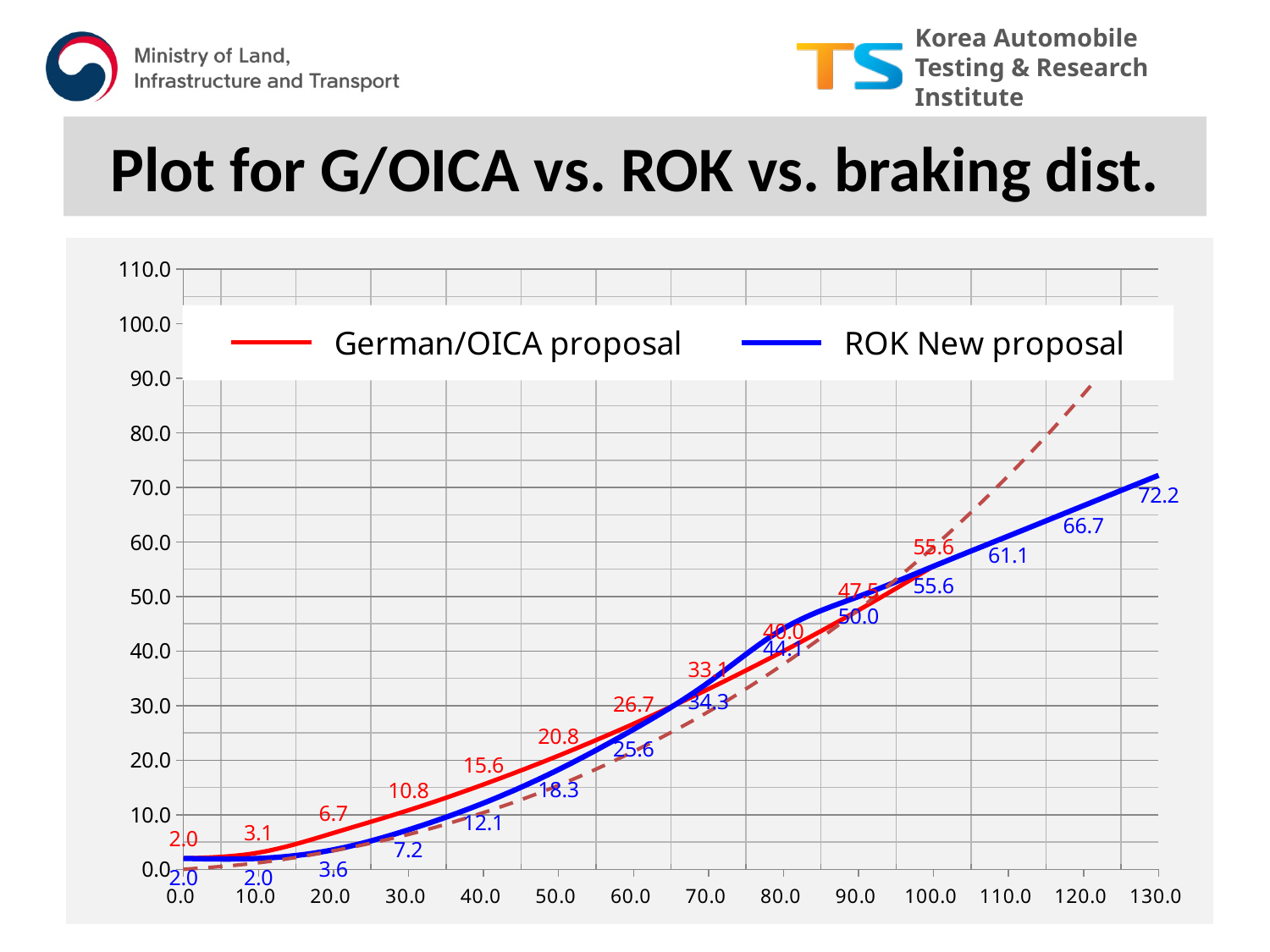
What is the value of the ROK New proposal line at x = 130.0? 72.2 Do the values of the ROK New proposal line rise or fall as x increases? rise At x = 30.0, which series has the larger value, German/OICA proposal or ROK New proposal? German/OICA proposal What colour is the ROK New proposal line in the legend? blue What kind of chart is shown on the slide? line chart At x = 80.0, which series has the larger value, German/OICA proposal or ROK New proposal? ROK New proposal What is the value of the German/OICA proposal line at x = 100.0? 55.6 What is the highest labelled value on the ROK New proposal line? 72.2 What is the value of the ROK New proposal line at x = 40.0? 12.1 What is the value of the German/OICA proposal line at x = 50.0? 20.8 What is the difference between the ROK New proposal value and the German/OICA proposal value at x = 80.0? 4.1 How many series does the legend list? 2